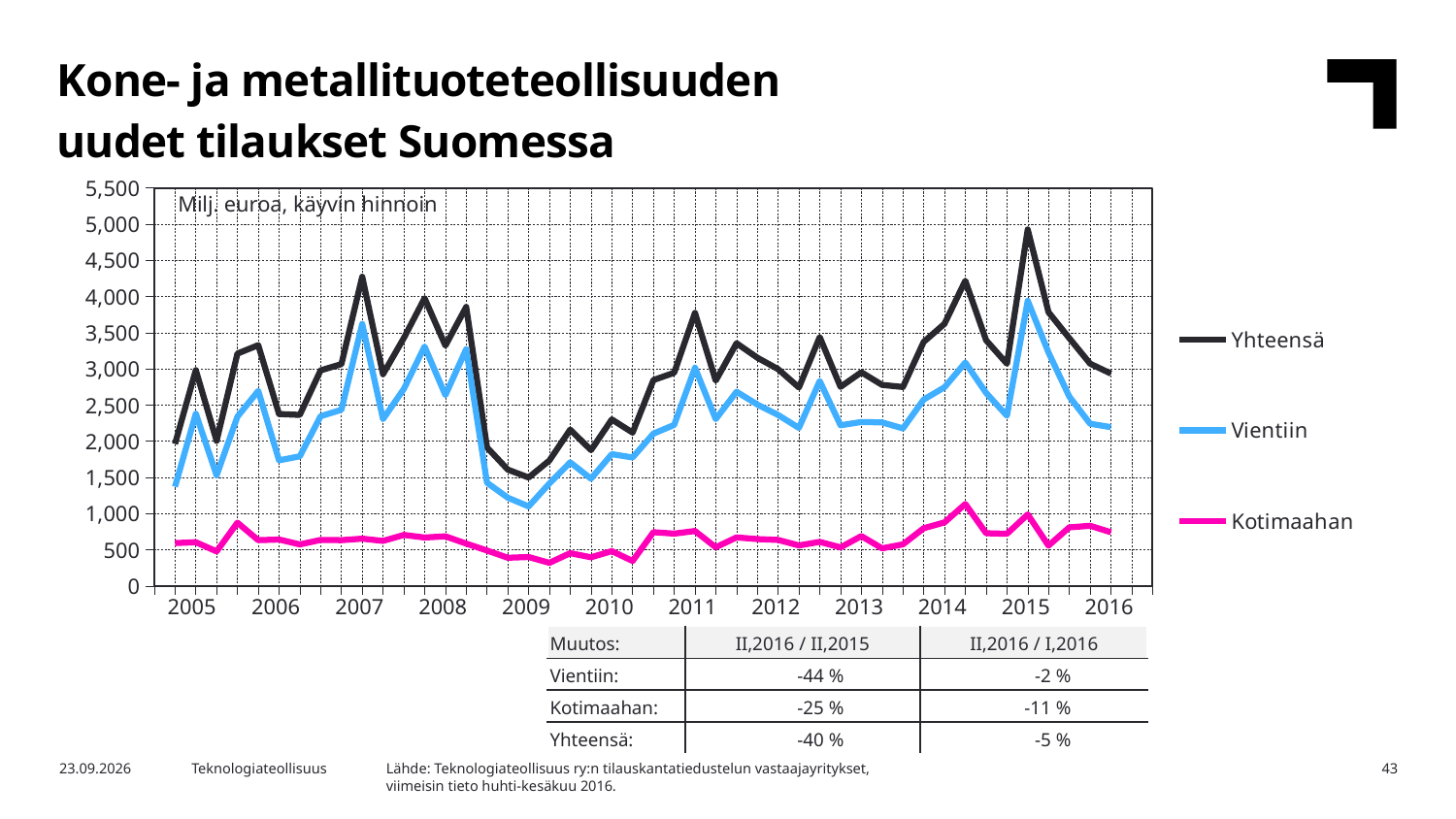
Which series has the lowest values throughout the chart? Kotimaahan Is the value for Kotimaahan in 2009 greater or less than 1,000? less Does the Yhteensä line rise or fall from 2008 to 2009? fall Is the peak value of Yhteensä in 2015 greater or less than 4,500? greater Which is larger in 2011, Vientiin or Kotimaahan? Vientiin In which year does the Yhteensä line reach its highest peak? 2015 Which series are listed in the legend? Yhteensä, Vientiin, Kotimaahan Which series has the highest values throughout the chart? Yhteensä How many years are labelled on the x axis? 12 How many series does the legend list? 3 What unit is stated inside the chart area? Milj. euroa, käyvin hinnoin What kind of chart is shown on the slide? line chart